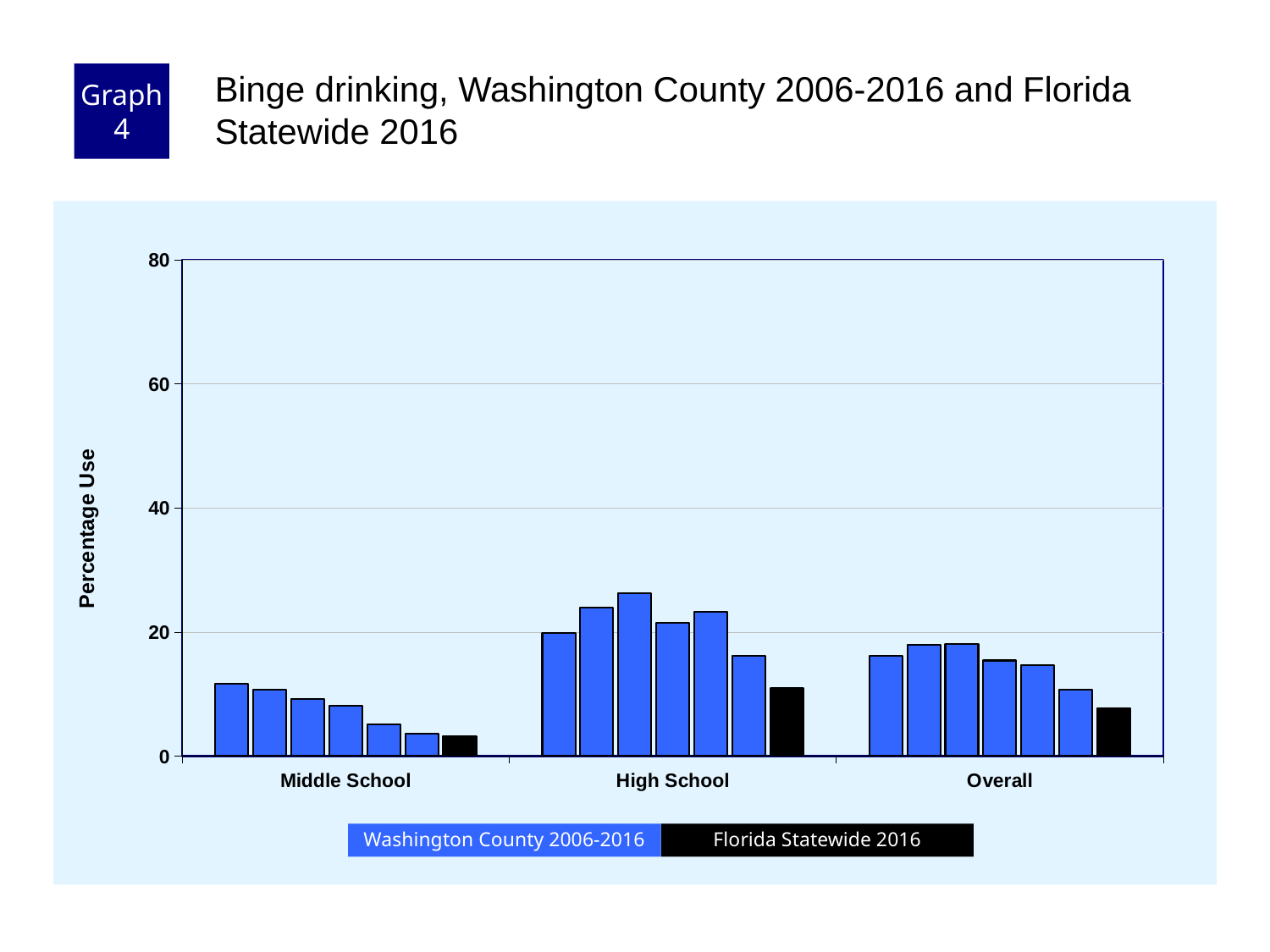
Are all the Middle School bars greater or less than 20? less Which category has the tallest bars overall? High School What is the label of the y axis? Percentage Use Which series is shown in black in the legend? Florida Statewide 2016 How many categories are shown on the x axis? 3 Which is larger, the Florida Statewide 2016 value for High School or for Middle School? High School What kind of chart is shown on the slide? bar chart Is the tallest Washington County 2006-2016 bar for High School greater or less than 20? greater Is the Florida Statewide 2016 value for Middle School greater or less than 20? less Which category has the shortest bars overall? Middle School How many series does the legend list? 2